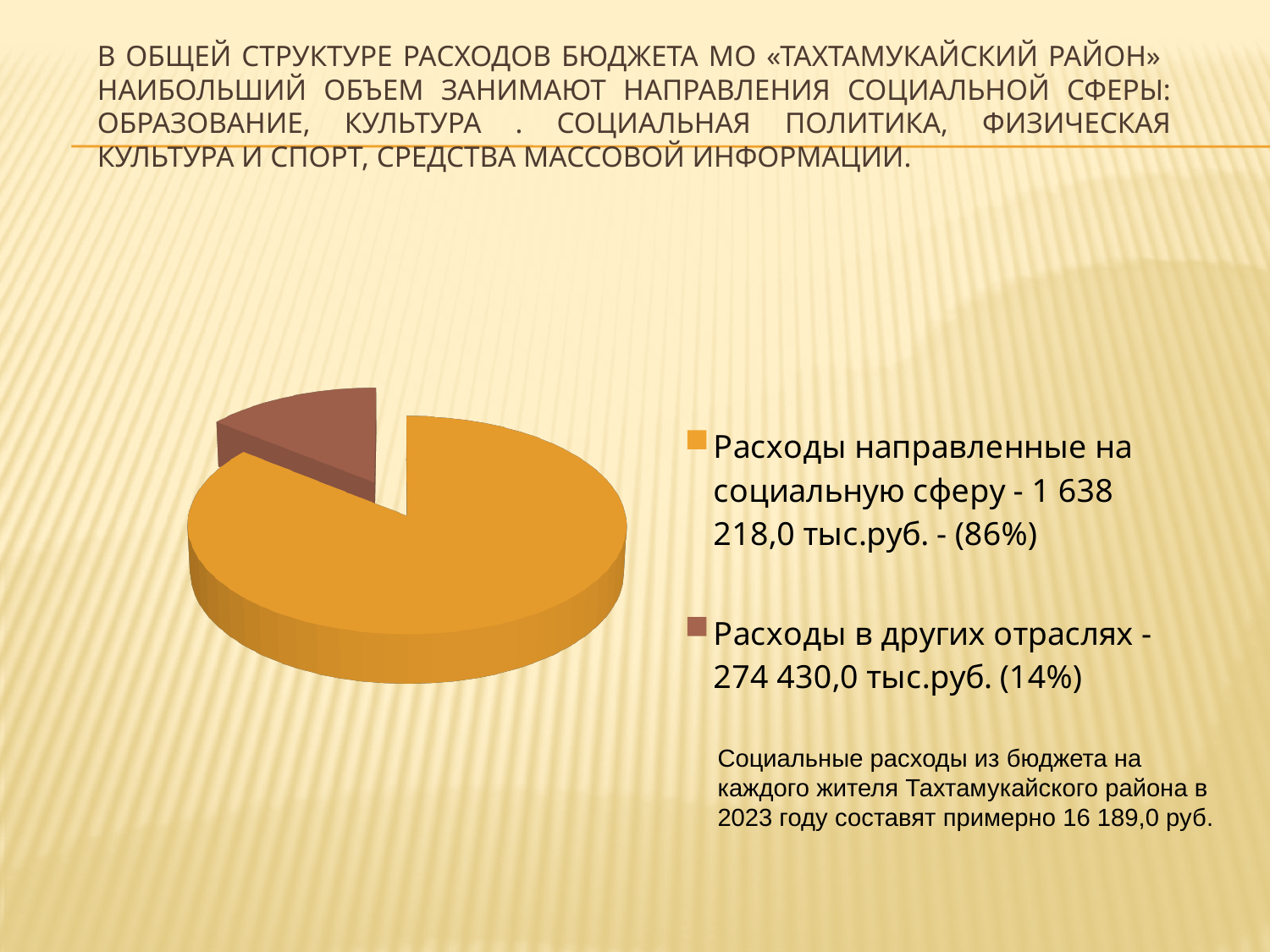
What colour is the slice for "Расходы в других отраслях"? Brown How many entries does the legend of the pie chart list? 2 How many slices does the pie chart have? 2 What share of the pie does "Расходы направленные на социальную сферу" take? 86% What kind of chart is shown on the slide? Pie chart What value is given for "Расходы в других отраслях"? 274 430,0 тыс.руб. What share of the pie does "Расходы в других отраслях" take? 14% Which slice of the pie chart is the smallest? Расходы в других отраслях By how many percentage points does the share of "Расходы направленные на социальную сферу" exceed the share of "Расходы в других отраслях"? 72 Which slice of the pie chart is the largest? Расходы направленные на социальную сферу What value is given for "Расходы направленные на социальную сферу"? 1 638 218,0 тыс.руб. Which is larger: "Расходы направленные на социальную сферу" or "Расходы в других отраслях"? Расходы направленные на социальную сферу